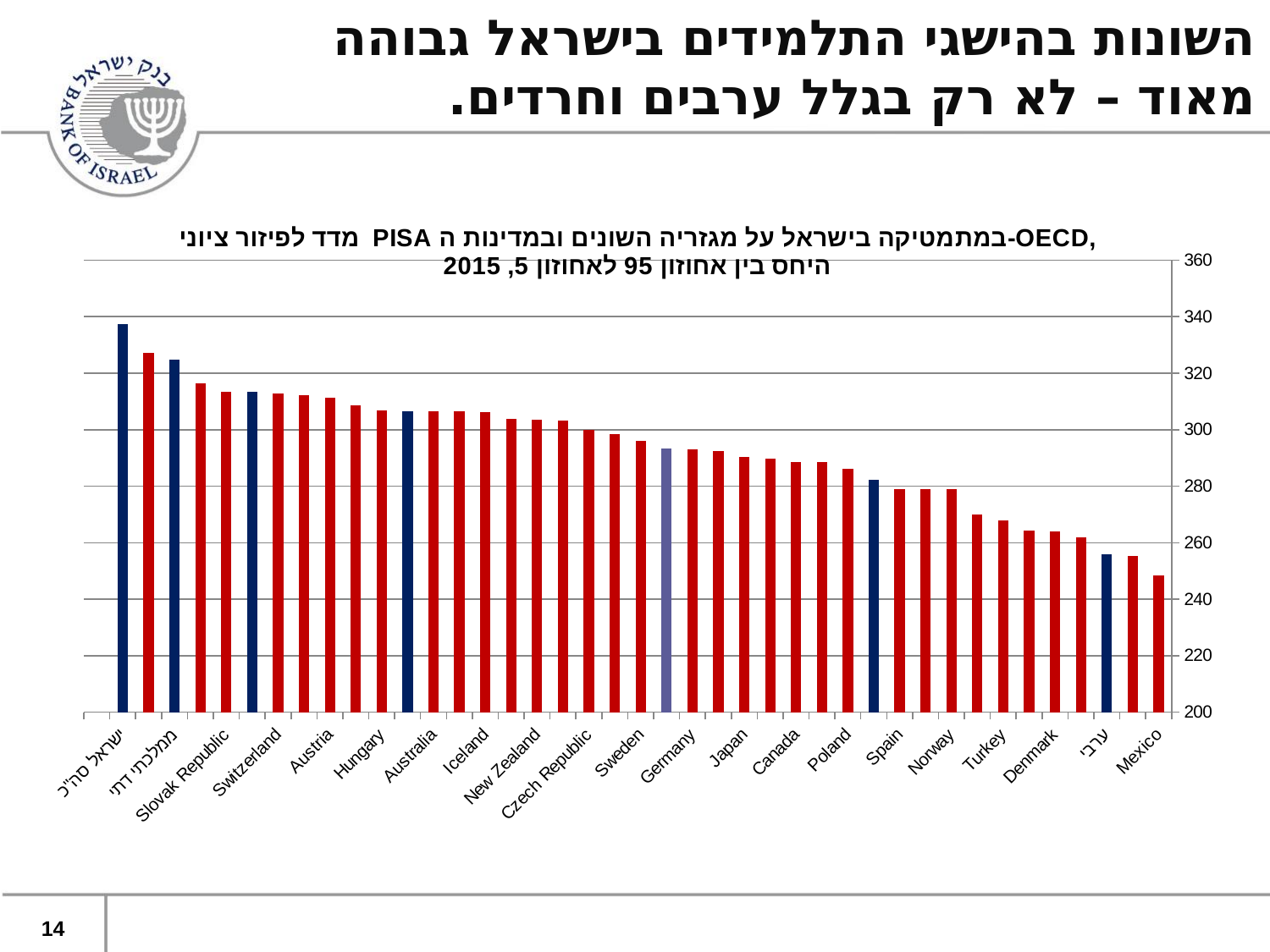
Is the value for Slovak Republic greater or less than 320? less Is the value for ישראל סה"כ greater or less than 320? greater Which category has the highest value in the chart? ישראל סה"כ Do the values rise or fall moving from left to right along the x axis? fall Which category has the lowest value in the chart? Mexico Which is larger, the value for Slovak Republic or the value for Denmark? Slovak Republic Is the value for Turkey greater or less than 280? less What kind of chart is shown on the slide? bar chart What colour is the bar for ישראל סה"כ? dark blue